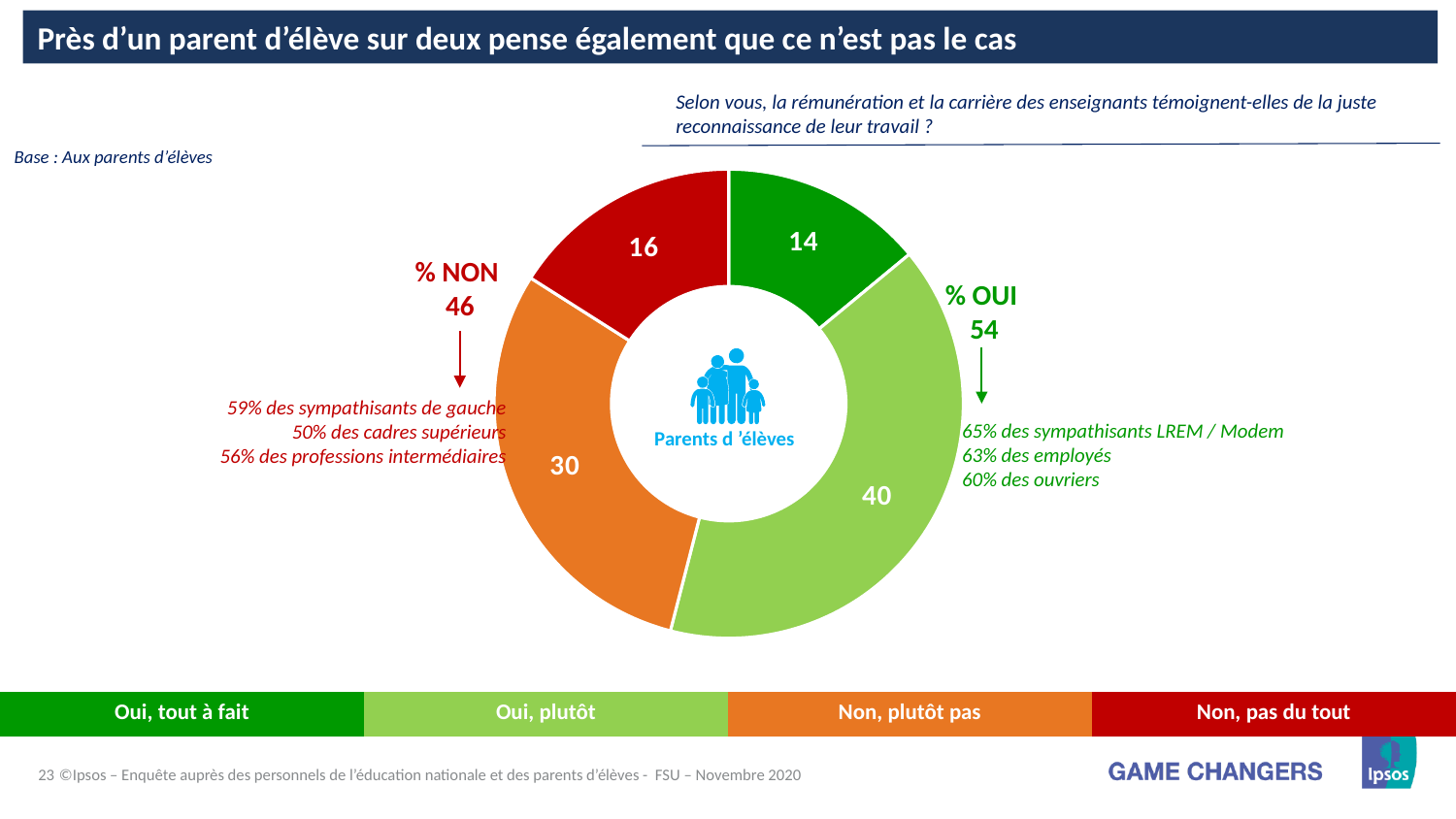
What is the value for "Oui, plutôt" in the donut chart? 40 What is the value for "Non, plutôt pas" in the donut chart? 30 How many categories does the legend of the donut chart list? 4 What kind of chart is shown on the slide? Pie chart (donut) What is the value for "Oui, tout à fait" in the donut chart? 14 What is the total % OUI shown next to the donut chart? 54 Which category has the smallest slice in the donut chart? Oui, tout à fait Which is larger, the value for "Non, pas du tout" or the value for "Oui, tout à fait"? Non, pas du tout Which category has the largest slice in the donut chart? Oui, plutôt What is the difference between the values for "Oui, plutôt" and "Non, plutôt pas"? 10 What is the value for "Non, pas du tout" in the donut chart? 16 What label is shown in the centre of the donut chart? Parents d'élèves